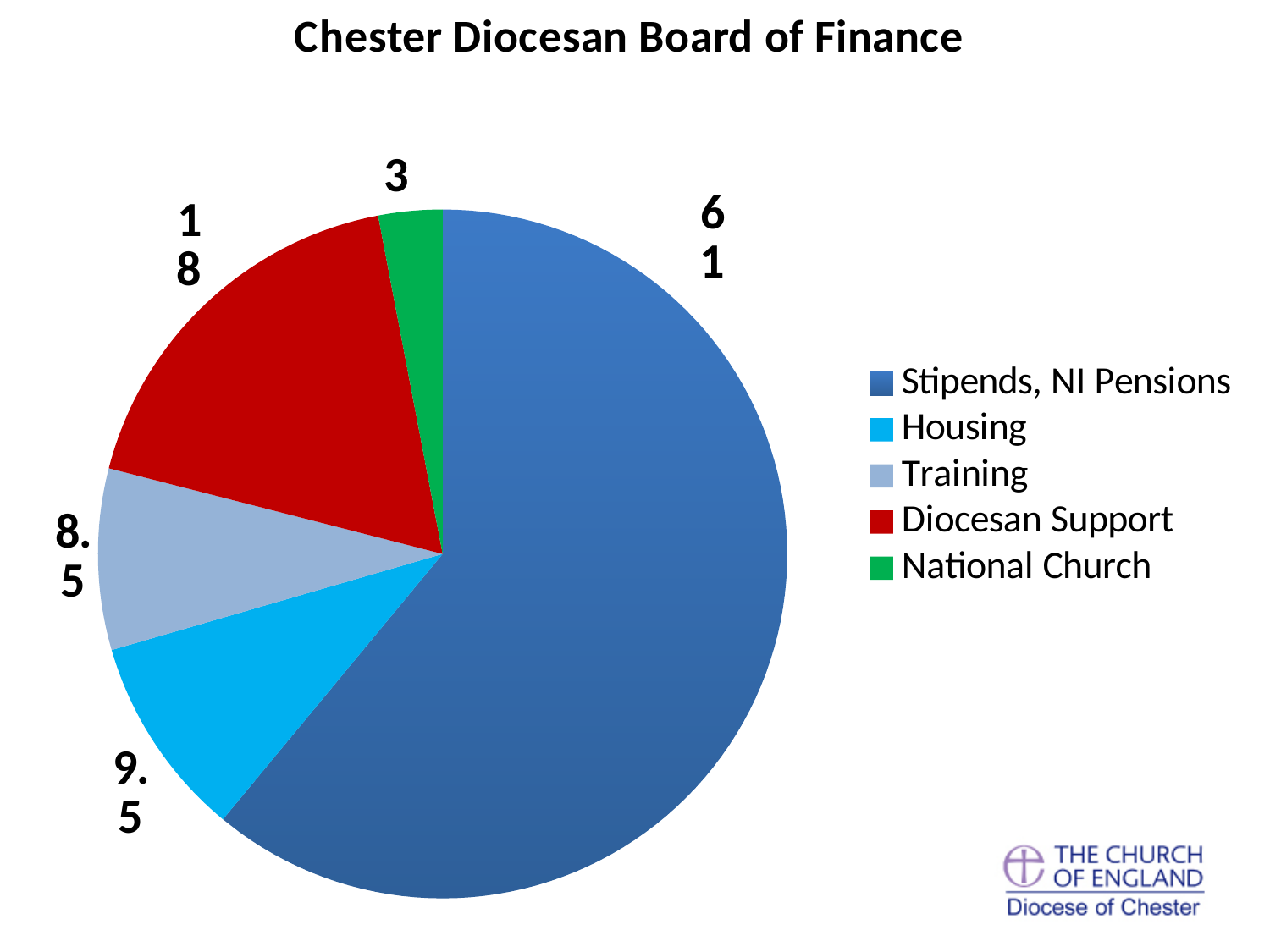
What is the value for Housing? 9.5 What is the difference between the values for Stipends, NI Pensions and Diocesan Support? 43 Which category has the largest slice of the pie? Stipends, NI Pensions Which is larger, the value for Housing or the value for Training? Housing Which category has the smallest slice of the pie? National Church What is the value for Training? 8.5 What type of chart is shown on the slide? pie chart What is the value for Diocesan Support? 18 What is the title of the chart? Chester Diocesan Board of Finance What is the value for National Church? 3 How many categories does the legend list? 5 What is the value for Stipends, NI Pensions? 61